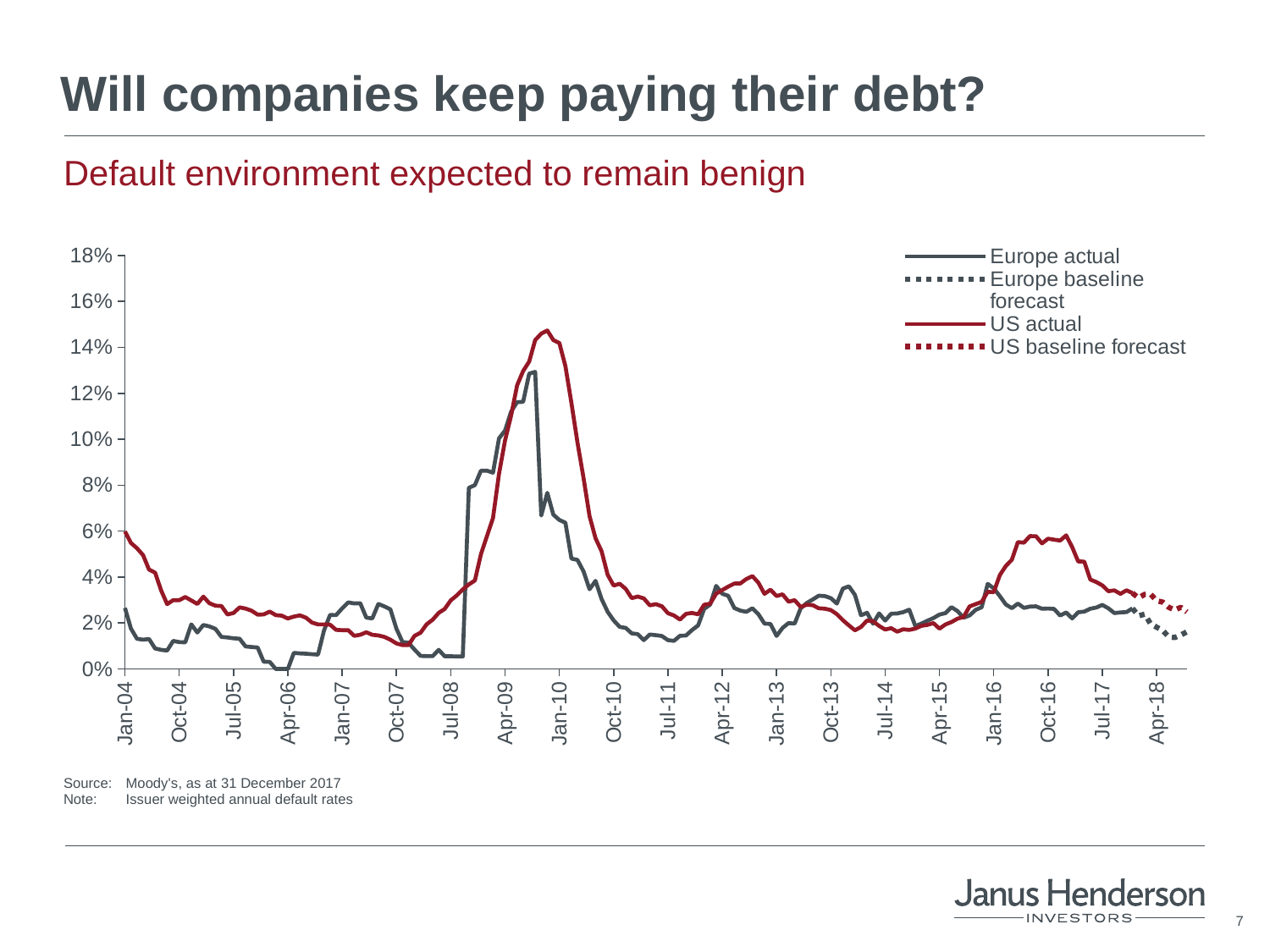
Is the peak value of the Europe actual series greater or less than 12%? greater What colour is the US actual line? red Around Oct-16, which is higher, US actual or Europe actual? US actual Which series reaches the highest peak on the chart? US actual Is the value of Europe actual at Jan-04 greater or less than 4%? less How many series does the legend list? 4 Is the value of US actual at Jan-04 greater or less than 4%? greater What is the source of the chart data? Moody's, as at 31 December 2017 Does the Europe baseline forecast rise or fall after Jul-17? fall At Jan-04, which is higher, US actual or Europe actual? US actual What kind of chart is shown on the slide? line chart